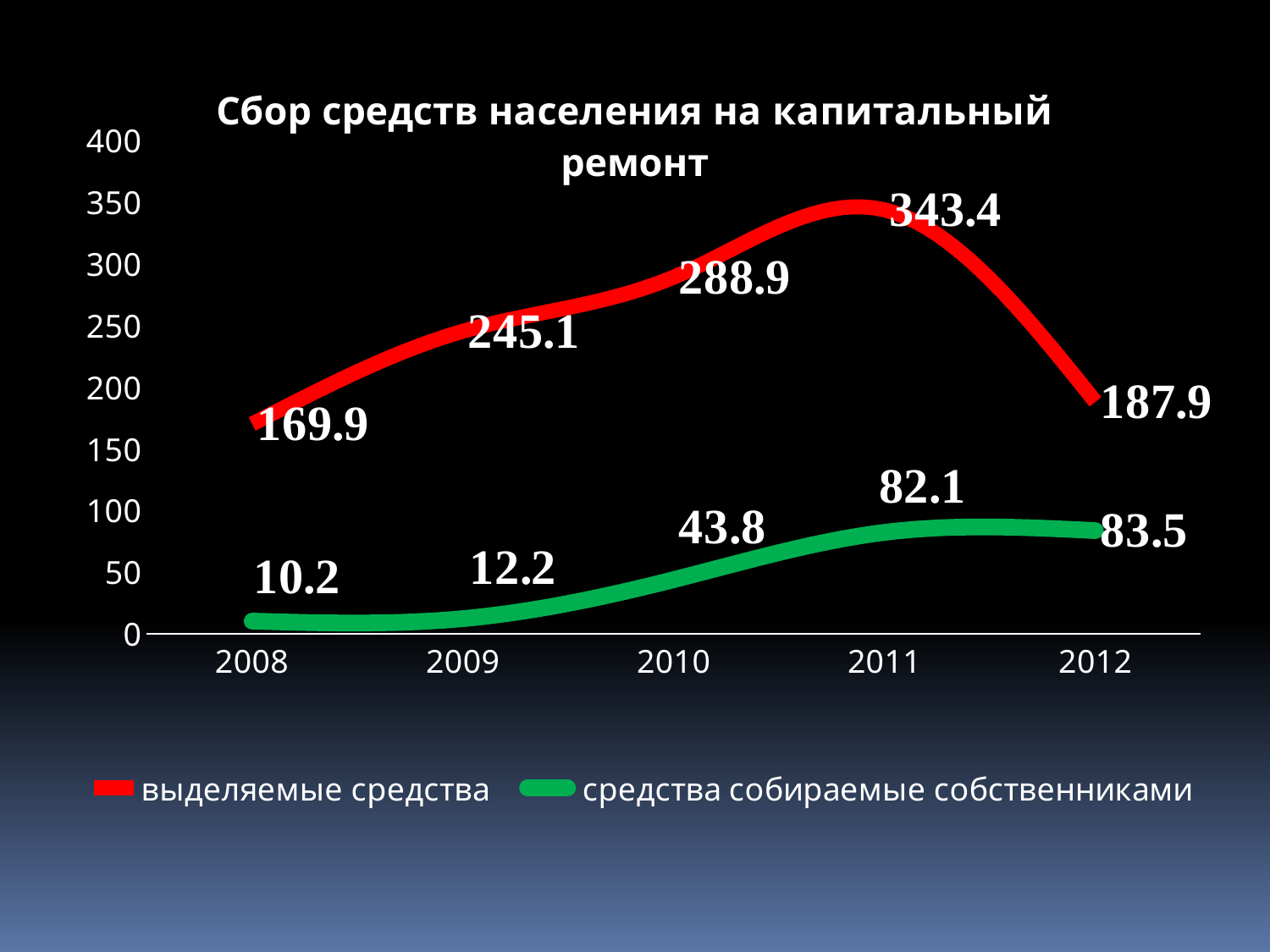
Which is larger: средства собираемые собственниками in 2010 or in 2011? 2011 What colour is the line for выделяемые средства? red How many years are shown on the x axis? 5 What is the value of выделяемые средства in 2011? 343.4 What is the difference between выделяемые средства in 2011 and in 2012? 155.5 What is the value of средства собираемые собственниками in 2008? 10.2 What kind of chart is this? line chart In which year is средства собираемые собственниками lowest? 2008 In which year is выделяемые средства highest? 2011 What is the value of выделяемые средства in 2012? 187.9 How many series does the legend list? 2 Does средства собираемые собственниками rise or fall from 2008 to 2011? rise